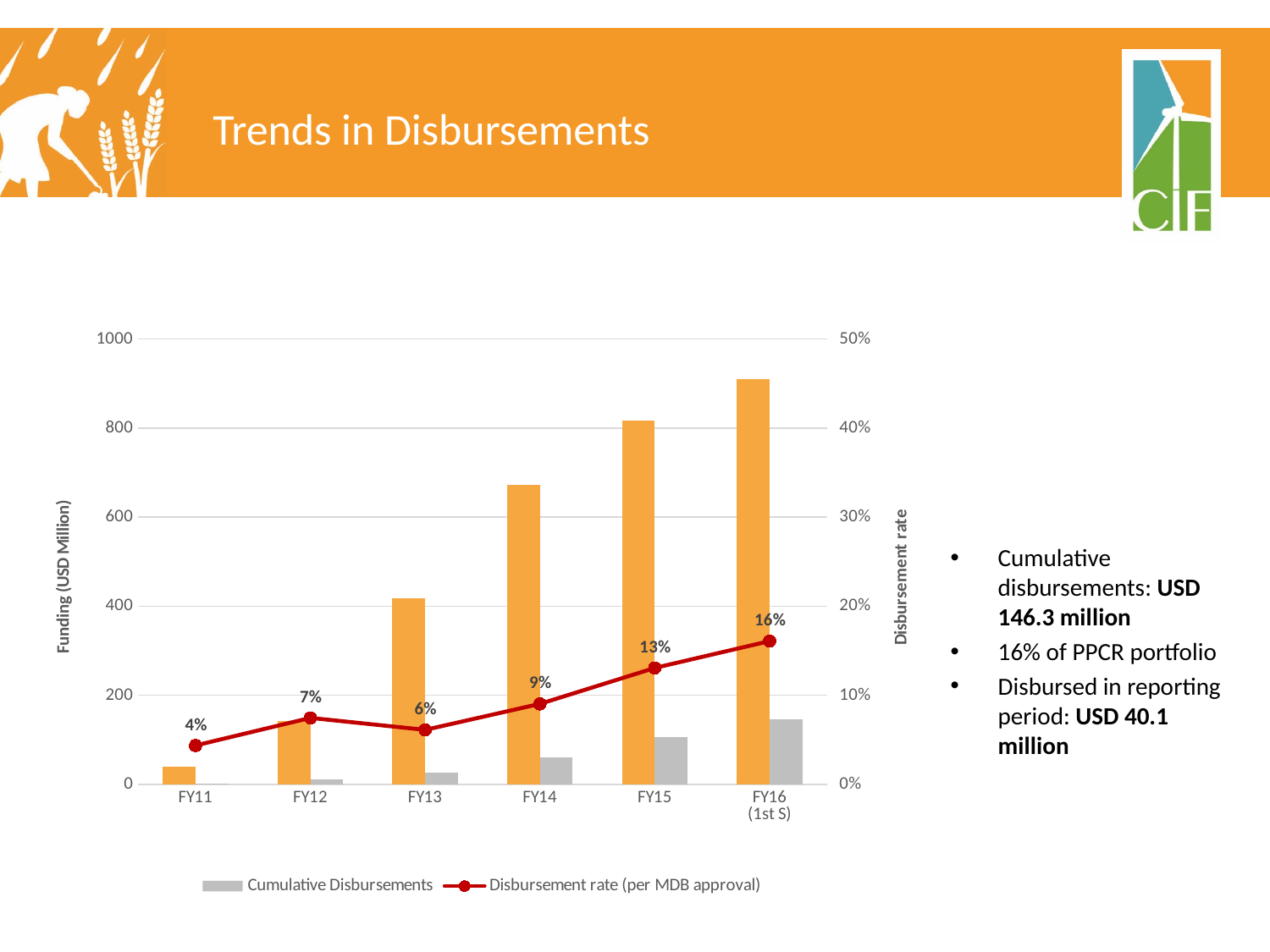
How many fiscal years are shown on the x axis? 6 What is the difference between the disbursement rate in FY16 (1st S) and in FY11? 12% What kind of chart is shown on the slide? Combination bar and line chart Which fiscal year has the highest disbursement rate? FY16 (1st S) Is the orange bar for FY15 greater or less than 800? greater How many series does the legend list? 2 Does the disbursement rate rise or fall from FY13 to FY16 (1st S)? Rises Which fiscal year has the lowest disbursement rate? FY11 What is the disbursement rate for FY14? 9% What is the disbursement rate for FY16 (1st S)? 16% Which has the higher disbursement rate, FY12 or FY13? FY12 Is the Cumulative Disbursements value for FY16 (1st S) greater or less than 200? less